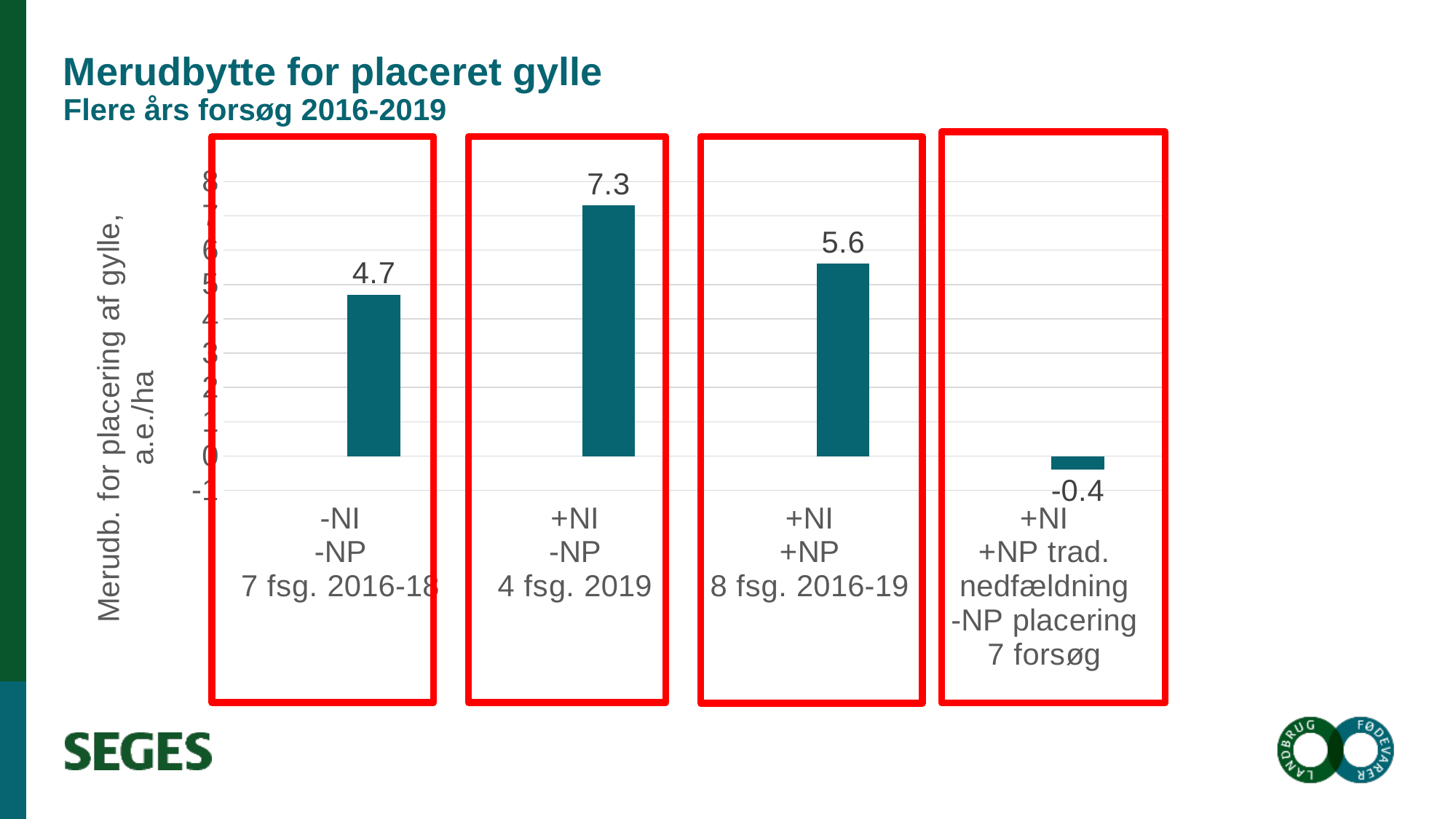
What is the value for the category "+NI +NP trad. nedfældning -NP placering 7 forsøg"? -0.4 What is the value for the category "-NI -NP 7 fsg. 2016-18"? 4.7 What is the value for the category "+NI -NP 4 fsg. 2019"? 7.3 How many categories are shown in the chart? 4 How many bars have a negative value? 1 What is the value for the category "+NI +NP 8 fsg. 2016-19"? 5.6 Which is larger, the value for "+NI +NP 8 fsg. 2016-19" or the value for "-NI -NP 7 fsg. 2016-18"? +NI +NP 8 fsg. 2016-19 Which category has the lowest value? +NI +NP trad. nedfældning -NP placering 7 forsøg Which category has the highest value? +NI -NP 4 fsg. 2019 What is the y-axis label of the chart? Merudb. for placering af gylle, a.e./ha What kind of chart is shown on the slide? Bar chart What is the difference between the values for "+NI -NP 4 fsg. 2019" and "-NI -NP 7 fsg. 2016-18"? 2.6